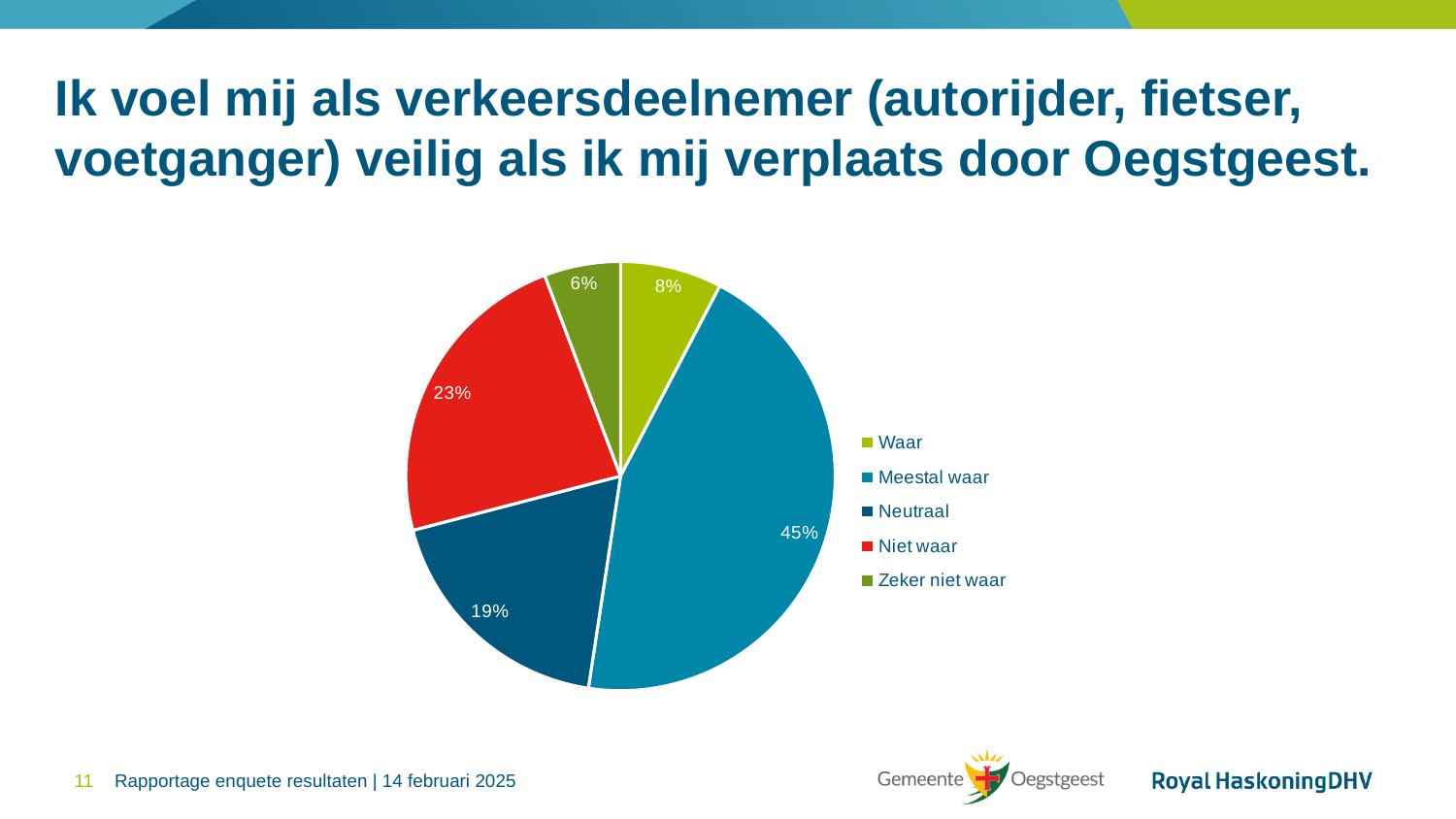
Which colour represents 'Niet waar' in the legend? red Which answer category has the smallest share of the pie? Zeker niet waar What percentage of respondents answered 'Meestal waar'? 45% What percentage of respondents answered 'Neutraal'? 19% What percentage of respondents answered 'Waar'? 8% What percentage of respondents answered 'Niet waar'? 23% Which is larger, the share for 'Niet waar' or the share for 'Neutraal'? Niet waar What is the difference in percentage points between 'Meestal waar' and 'Niet waar'? 22 What percentage of respondents answered 'Zeker niet waar'? 6% What kind of chart is shown on the slide? pie chart Which answer category has the largest share of the pie? Meestal waar How many categories does the pie chart have? 5